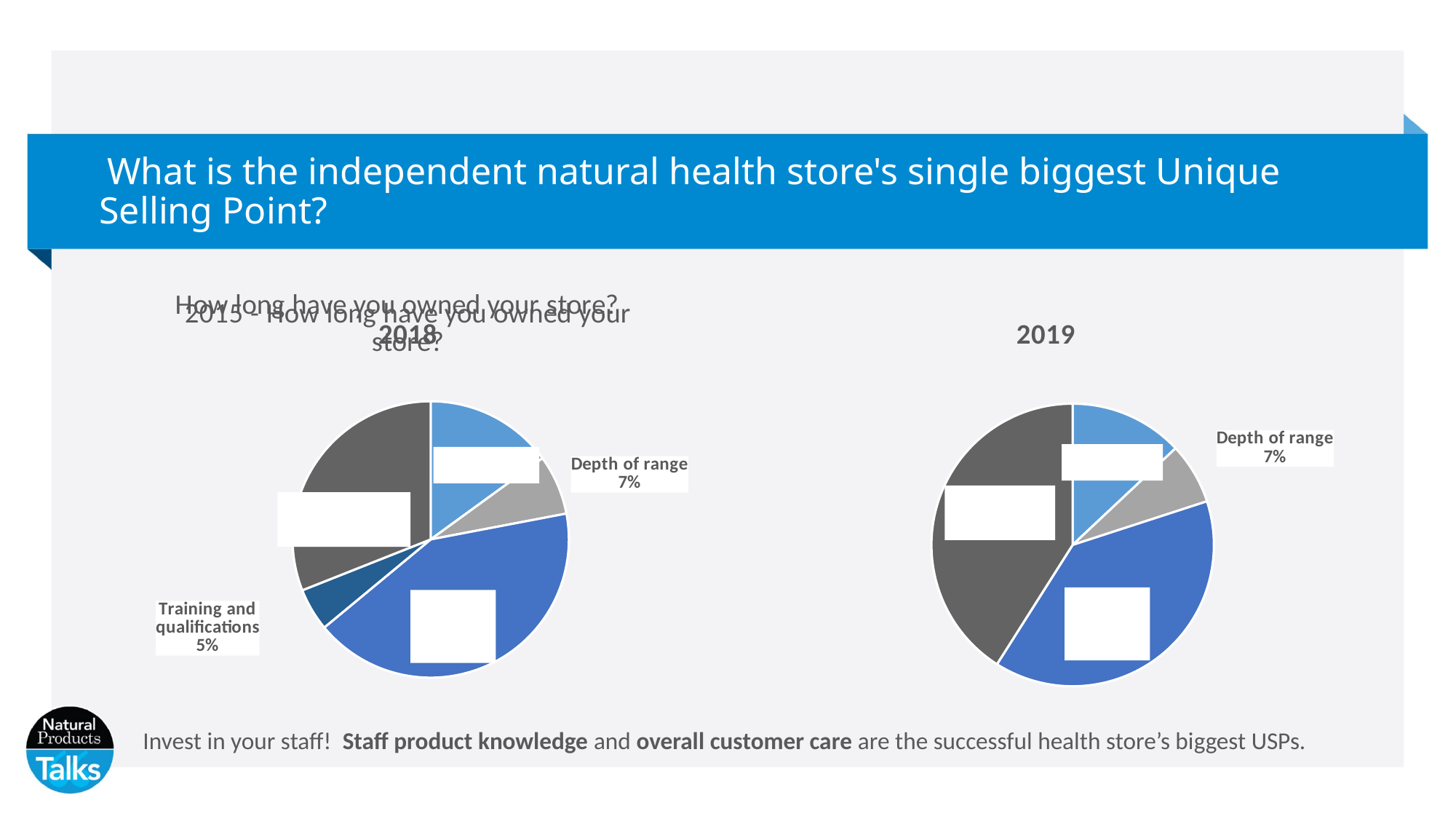
Did the labelled share for Depth of range change between the 2018 and 2019 pie charts? No, it is 7% in both In the 2018 pie chart, what is the difference between the Depth of range share and the Training and qualifications share? 2 percentage points In the 2018 pie chart, what share is labelled for Depth of range? 7% What is the title shown above the right-hand pie chart? 2019 In the 2018 pie chart, which labelled category has the smallest slice? Training and qualifications In the 2019 pie chart, what colour is the Depth of range slice? Grey In the 2018 pie chart, which is larger: Depth of range or Training and qualifications? Depth of range In the 2018 pie chart, what share is labelled for Training and qualifications? 5% How many slices does the 2019 pie chart have? 4 What kind of chart is used for the 2018 data? Pie chart How many slices does the 2018 pie chart have? 5 In the 2019 pie chart, what share is labelled for Depth of range? 7%